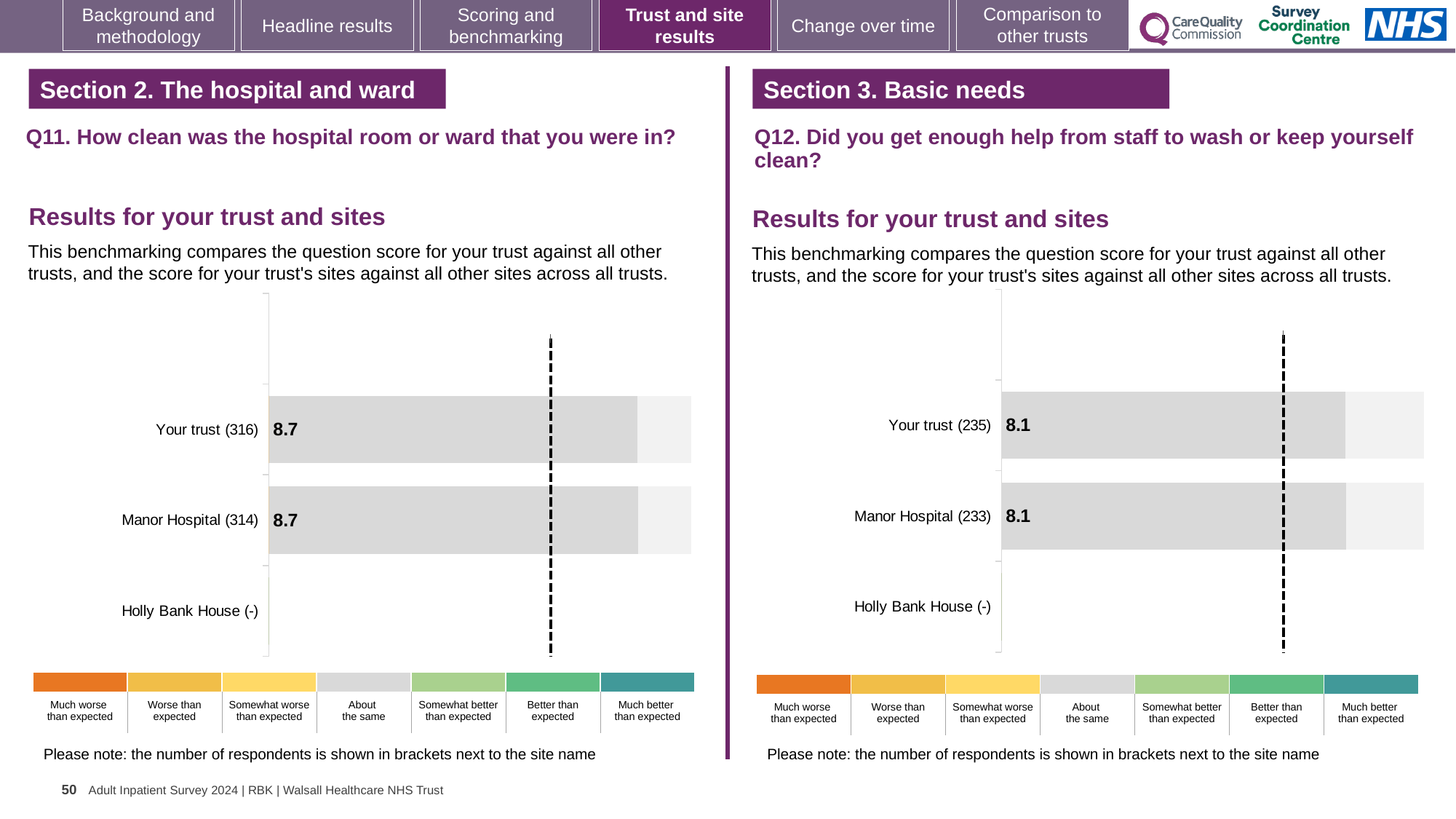
How many benchmark categories does the colour legend below the Q11 chart on the left list? 7 How many site/trust categories are listed on the y axis of the Q11 chart on the left? 3 How many site/trust categories are listed on the y axis of the Q12 chart on the right? 3 In the Q12 chart on the right, how many respondents are shown in brackets for Manor Hospital? 233 In the Q11 chart on the left, what is the score for Manor Hospital (314)? 8.7 In the Q12 chart on the right, what is the difference between the scores for Your trust and Manor Hospital? 0 In the Q11 chart on the left, what is the difference between the scores for Your trust and Manor Hospital? 0 In the Q12 chart on the right, what is the score for Manor Hospital (233)? 8.1 What kind of chart is used for the Q11 results on the left? Bar chart In the legend below the Q12 chart on the right, which category is shown in grey? About the same In the Q12 chart on the right, what is the score for Your trust (235)? 8.1 In the Q11 chart on the left, what is the score for Your trust (316)? 8.7